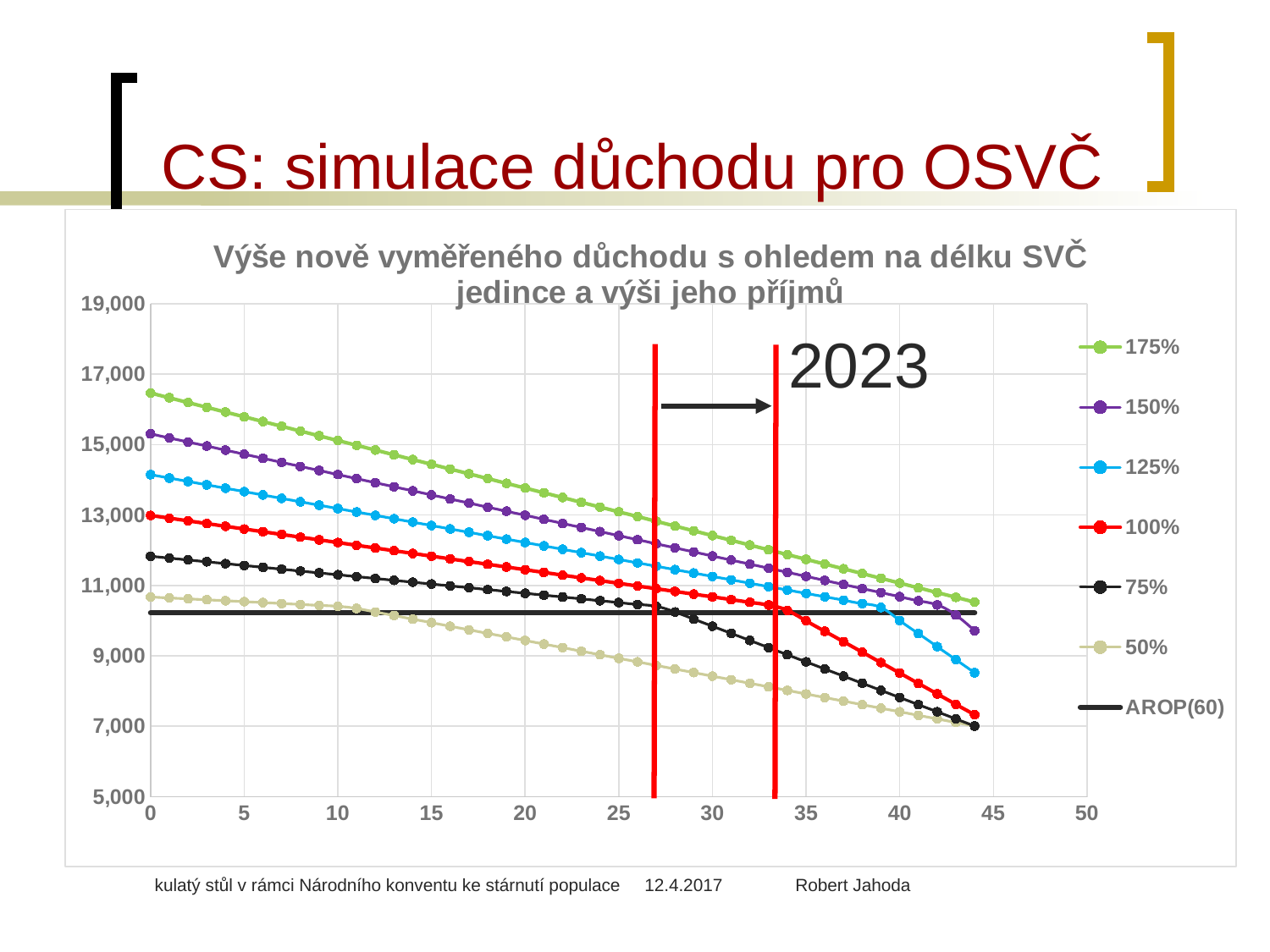
Is the value of the 125% series at its last point (x = 44) greater or less than 9,000? less At x = 20, which series has the larger value, 150% or 75%? 150% Which legend entry is drawn as a flat black horizontal line? AROP(60) How many series does the legend list? 7 Which of the coloured dotted series has the lowest value at x = 0? 50% Is the value of the 75% series at x = 0 greater or less than 11,000? greater Do the values of the 100% series rise or fall as x increases? fall Is the value of the 125% series at x = 0 greater or less than 13,000? greater Which series has the highest value at x = 0? 175% What is the title of the chart? Výše nově vyměřeného důchodu s ohledem na délku SVČ jedince a výši jeho příjmů What kind of chart is shown on the slide? line chart